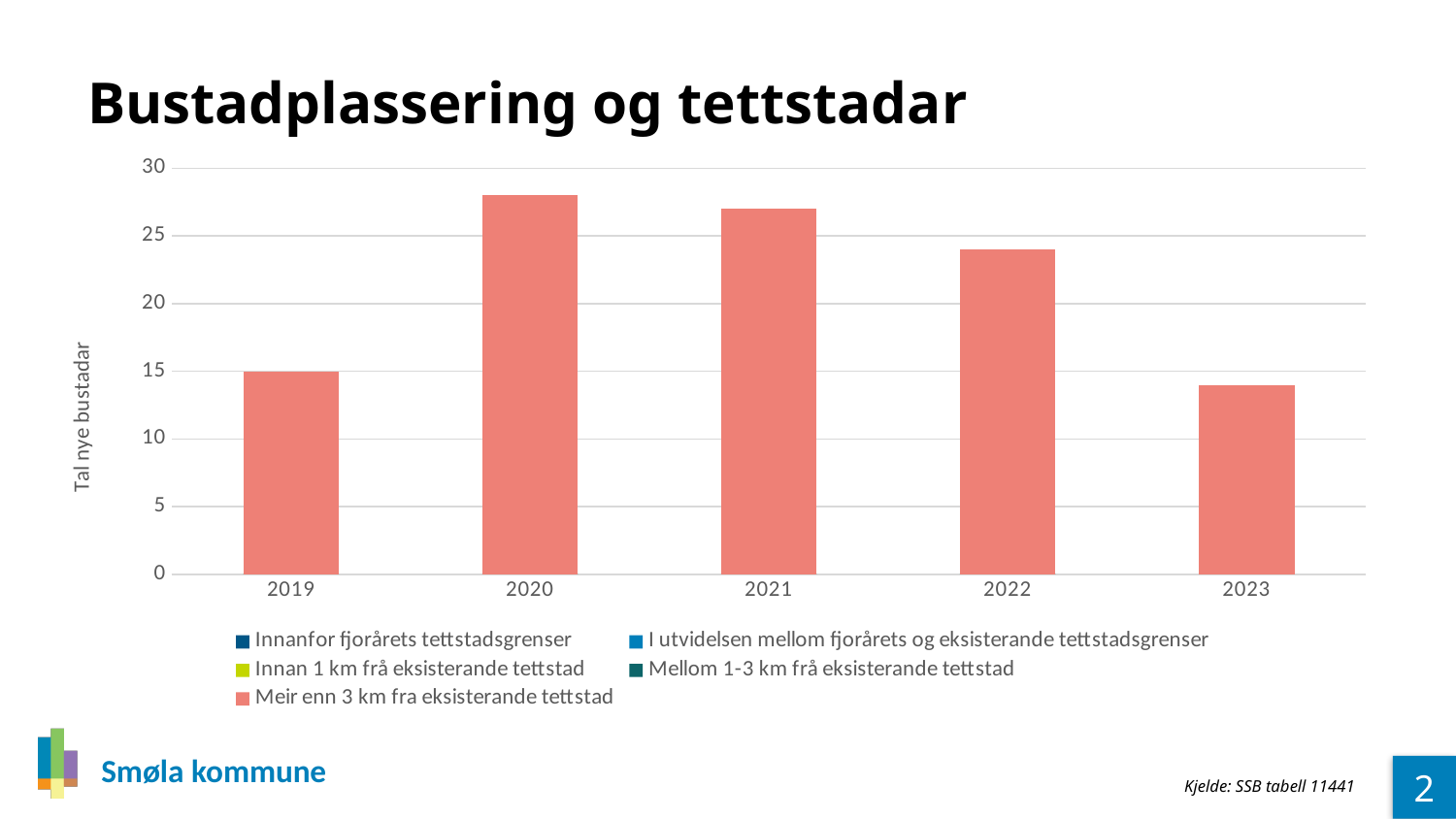
What type of chart is shown on the slide? Bar chart Do the values rise or fall from 2020 to 2023? fall How many years are shown on the x axis of the chart? 5 Which year has the highest bar? 2020 Is the value for 2023 greater or less than 15? less Is the value for 2020 greater or less than 25? greater Which year has the lowest bar? 2023 What is the label on the vertical axis of the chart? Tal nye bustadar How many series does the legend list? 5 Which year has the larger value, 2021 or 2022? 2021 Is the value for 2022 greater or less than 25? less What is the title of the chart on the slide? Bustadplassering og tettstadar